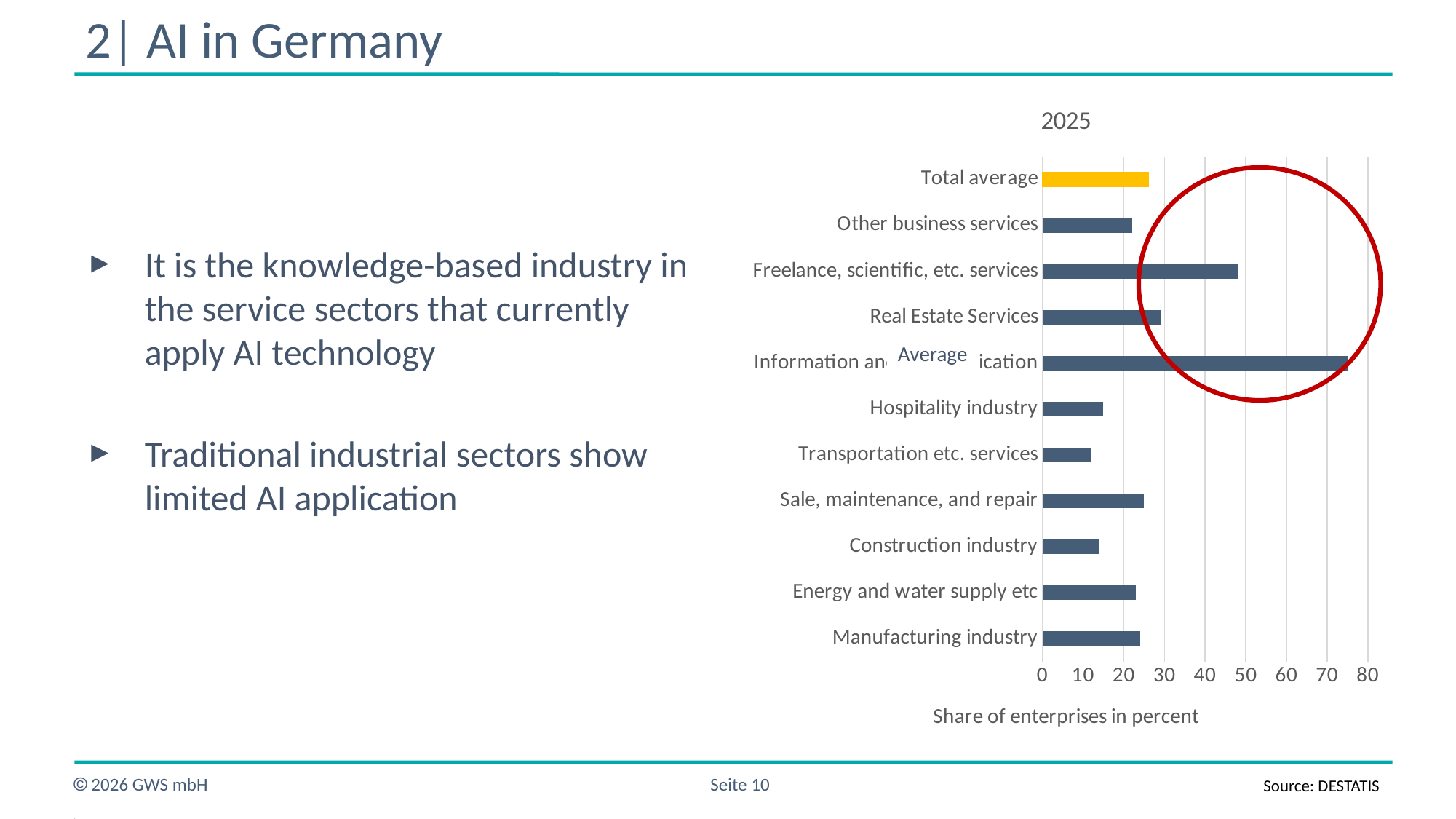
What kind of chart is shown on the slide? bar chart Is the value for Manufacturing industry greater or less than 30? less Which has the larger value, Freelance, scientific, etc. services or Real Estate Services? Freelance, scientific, etc. services What is the title of the chart? 2025 Is the value for Freelance, scientific, etc. services greater or less than 40? greater Is the value for Hospitality industry greater or less than 20? less What is the label of the horizontal axis? Share of enterprises in percent Which has the larger value, Hospitality industry or Sale, maintenance, and repair? Sale, maintenance, and repair How many categories (bars) does the chart show? 11